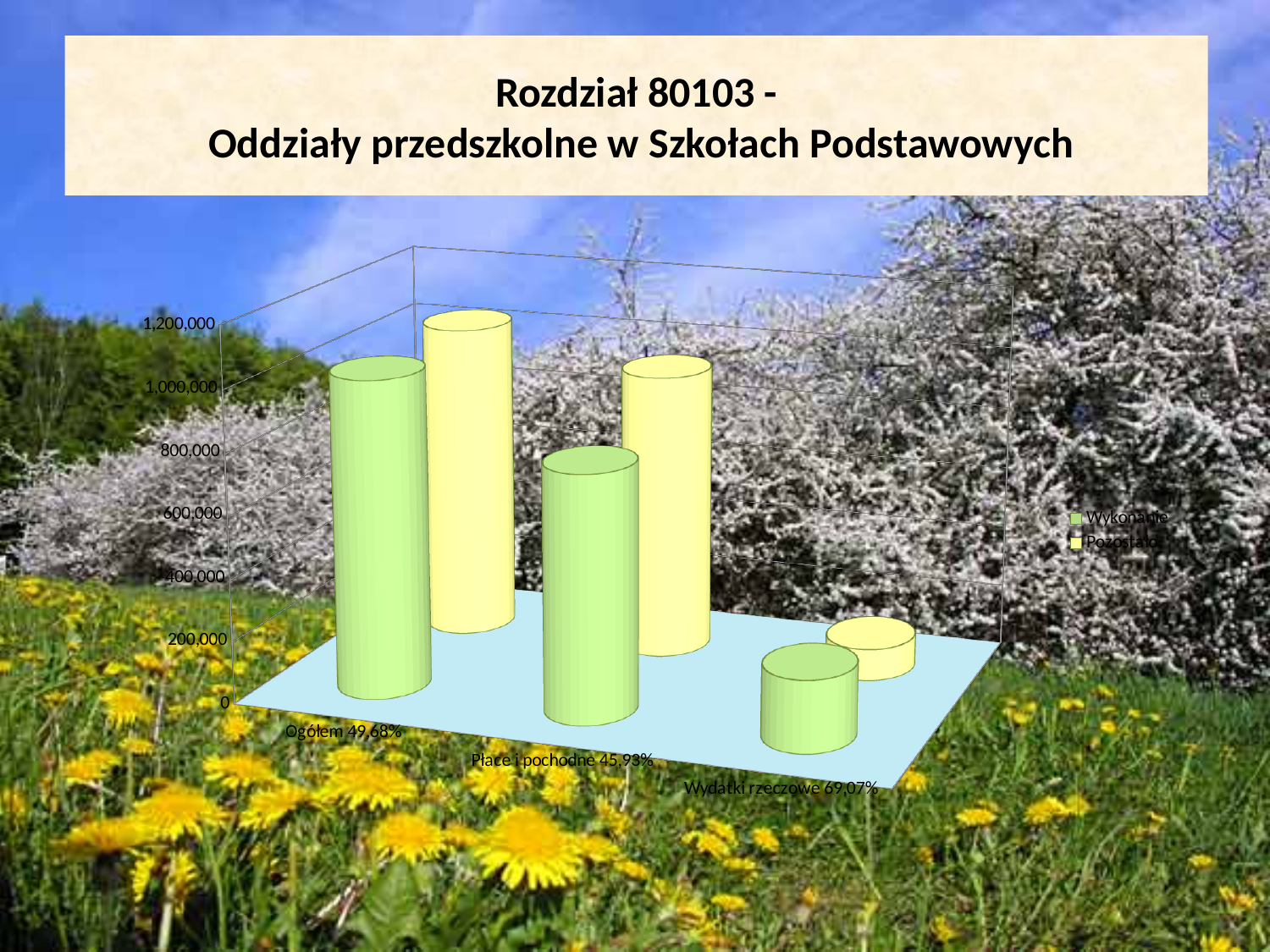
Is the Wykonanie value for Ogółem 49,68% greater or less than 600,000? greater How many series does the chart legend list? 2 Which category has the highest Wykonanie value? Ogółem 49,68% Is the Pozostało value for Ogółem 49,68% greater or less than 800,000? greater What are the two series named in the chart legend? Wykonanie and Pozostało How many categories are shown on the chart's horizontal axis? 3 What kind of chart is shown on the slide? bar chart What is the title of the slide containing the chart? Rozdział 80103 - Oddziały przedszkolne w Szkołach Podstawowych Which is larger for Płace i pochodne 45,93%: the Wykonanie value or the Pozostało value? Pozostało Is the Wykonanie value for Wydatki rzeczowe 69,07% greater or less than 400,000? less Which is larger: the Wykonanie value for Ogółem 49,68% or the Wykonanie value for Wydatki rzeczowe 69,07%? Ogółem 49,68% Which category has the lowest Pozostało value? Wydatki rzeczowe 69,07%